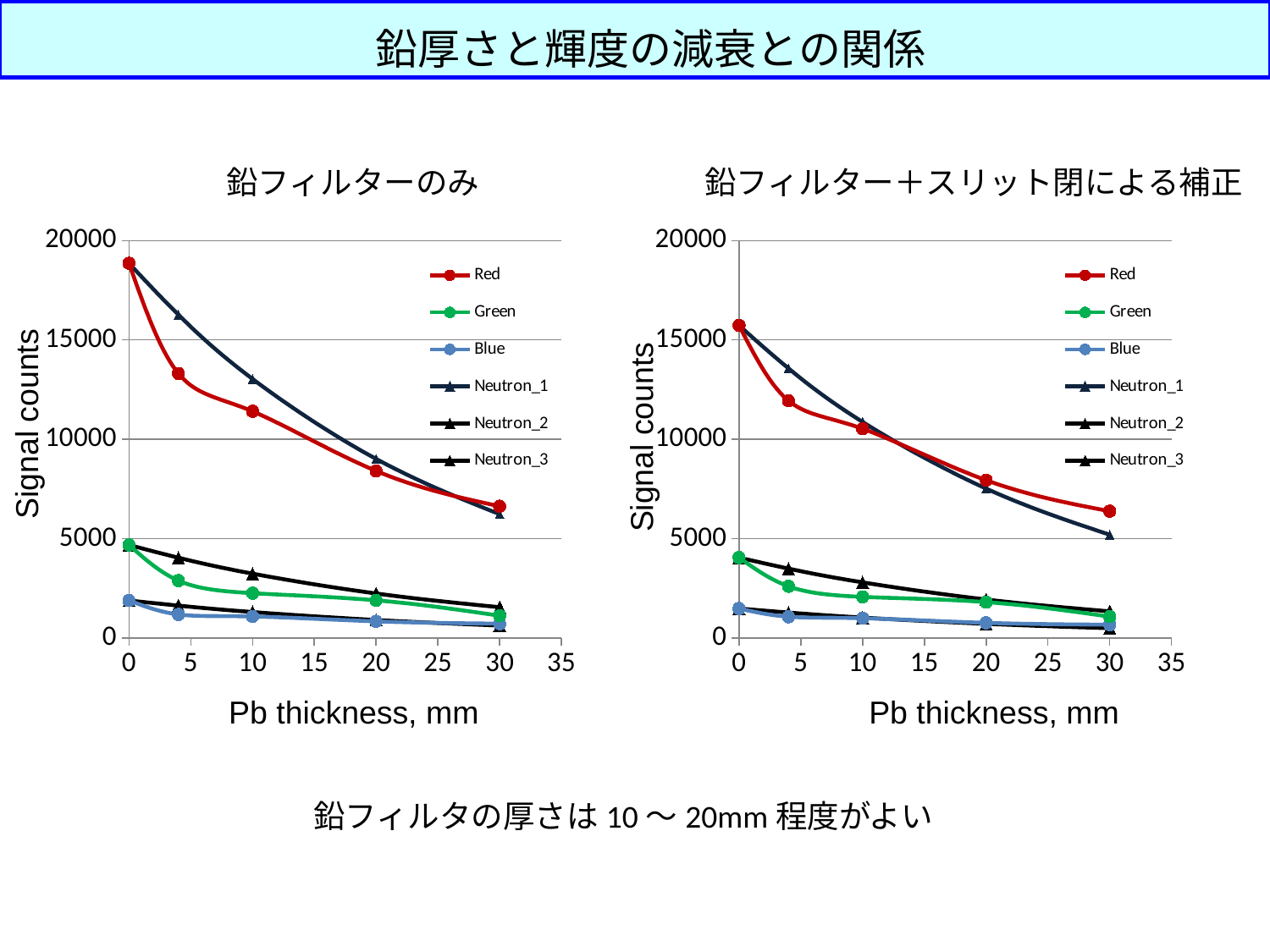
In the left chart (鉛フィルターのみ), is the Red value at 0 mm greater or less than 15000? greater In the left chart (鉛フィルターのみ), is the Red value at 10 mm greater or less than 10000? greater In the left chart (鉛フィルターのみ), how many data points are plotted for the Red series? 5 In the right chart (鉛フィルター＋スリット閉による補正), is the Red value at 20 mm greater or less than 10000? less In the left chart (鉛フィルターのみ), which is larger at 4 mm: Red or Neutron_1? Neutron_1 What is the y-axis label of the right chart (鉛フィルター＋スリット閉による補正)? Signal counts What is the x-axis label of the left chart (鉛フィルターのみ)? Pb thickness, mm In the right chart (鉛フィルター＋スリット閉による補正), which is larger at 30 mm: Red or Neutron_1? Red How many series does the legend of the right chart (鉛フィルター＋スリット閉による補正) list? 6 What kind of chart is the left chart titled 鉛フィルターのみ? line chart In the left chart (鉛フィルターのみ), does the Red series rise or fall as Pb thickness increases? fall